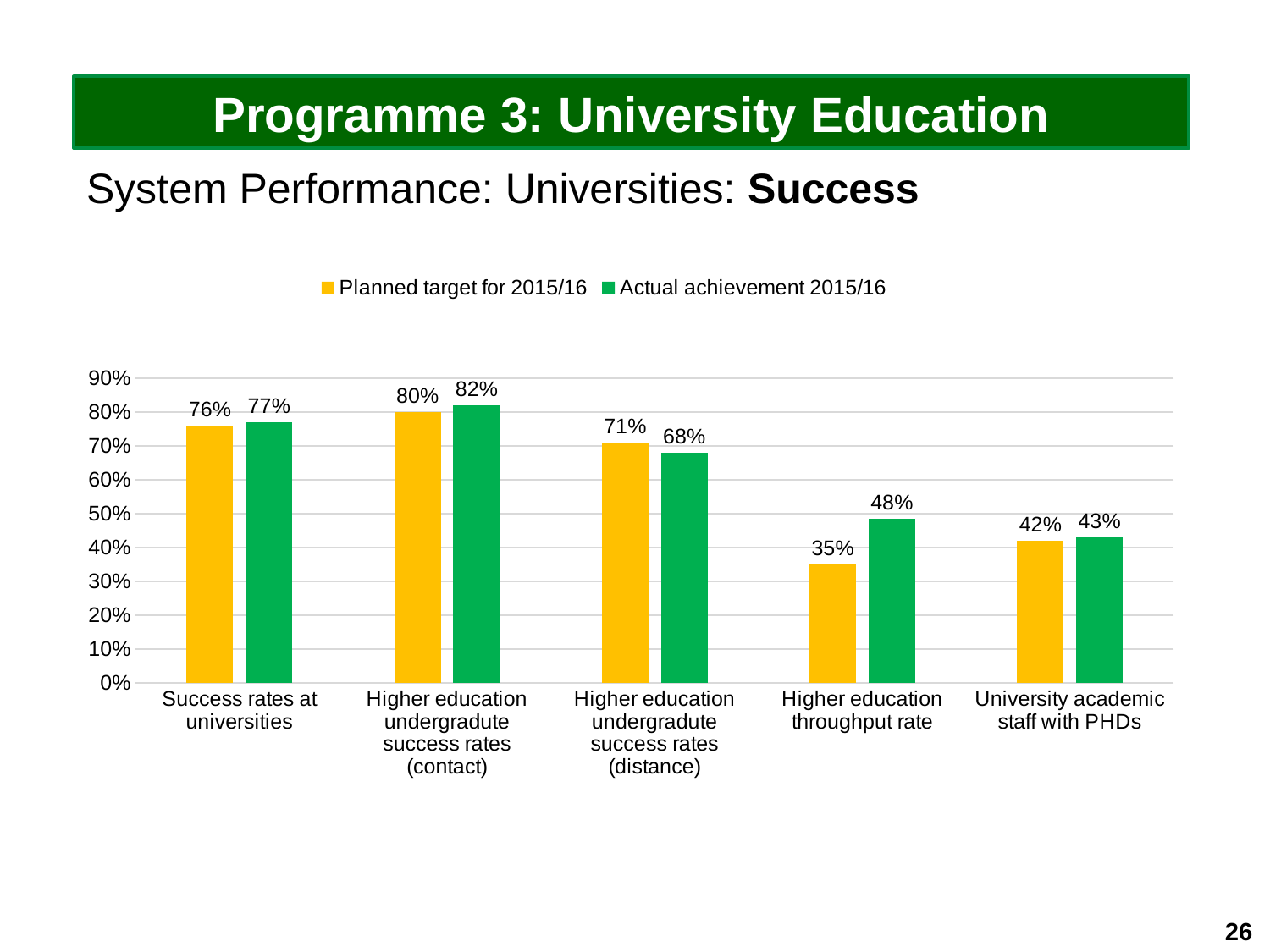
What was the actual achievement 2015/16 for University academic staff with PHDs? 43% How many series does the legend list? 2 What is the difference between the actual achievement and the planned target for Higher education throughput rate? 13% What kind of chart is shown on the slide? Bar chart What was the actual achievement 2015/16 for Higher education undergradute success rates (contact)? 82% Which category has the lowest planned target for 2015/16? Higher education throughput rate Which category has the highest actual achievement 2015/16? Higher education undergradute success rates (contact) Which colour represents the Actual achievement 2015/16 series? Green What was the planned target for 2015/16 for Higher education throughput rate? 35% Is the planned target for 2015/16 for Success rates at universities greater or less than 70%? greater How many categories are shown on the x axis of the chart? 5 For Higher education undergradute success rates (distance), which is larger: the planned target for 2015/16 or the actual achievement 2015/16? Planned target for 2015/16